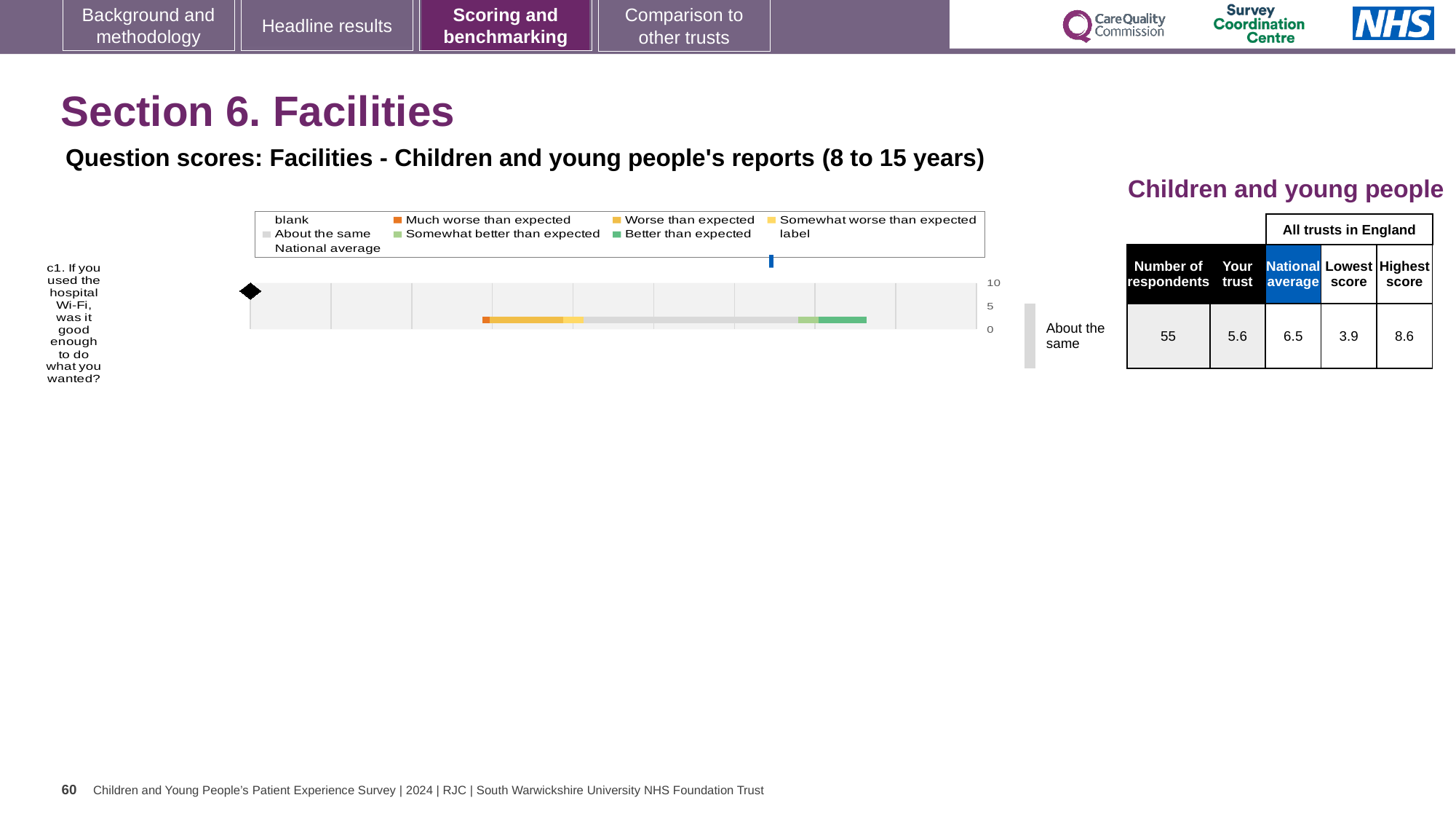
What is the 'Your trust' score for question c1 about the hospital Wi-Fi? 5.6 How many survey questions are plotted in the chart? 1 Which is larger for question c1: the 'Your trust' score or the national average? National average What kind of chart is shown on the slide? bar chart What is the lowest score across all trusts in England for question c1? 3.9 What is the national average score for question c1 about the hospital Wi-Fi? 6.5 How many respondents answered question c1 about the hospital Wi-Fi? 55 What is the highest value shown on the chart's score axis? 10 What is the difference between the highest score and the lowest score for question c1? 4.7 By how much does the national average exceed the 'Your trust' score for question c1? 0.9 Which benchmark category is the trust's result for question c1 placed in? About the same What is the highest score across all trusts in England for question c1? 8.6